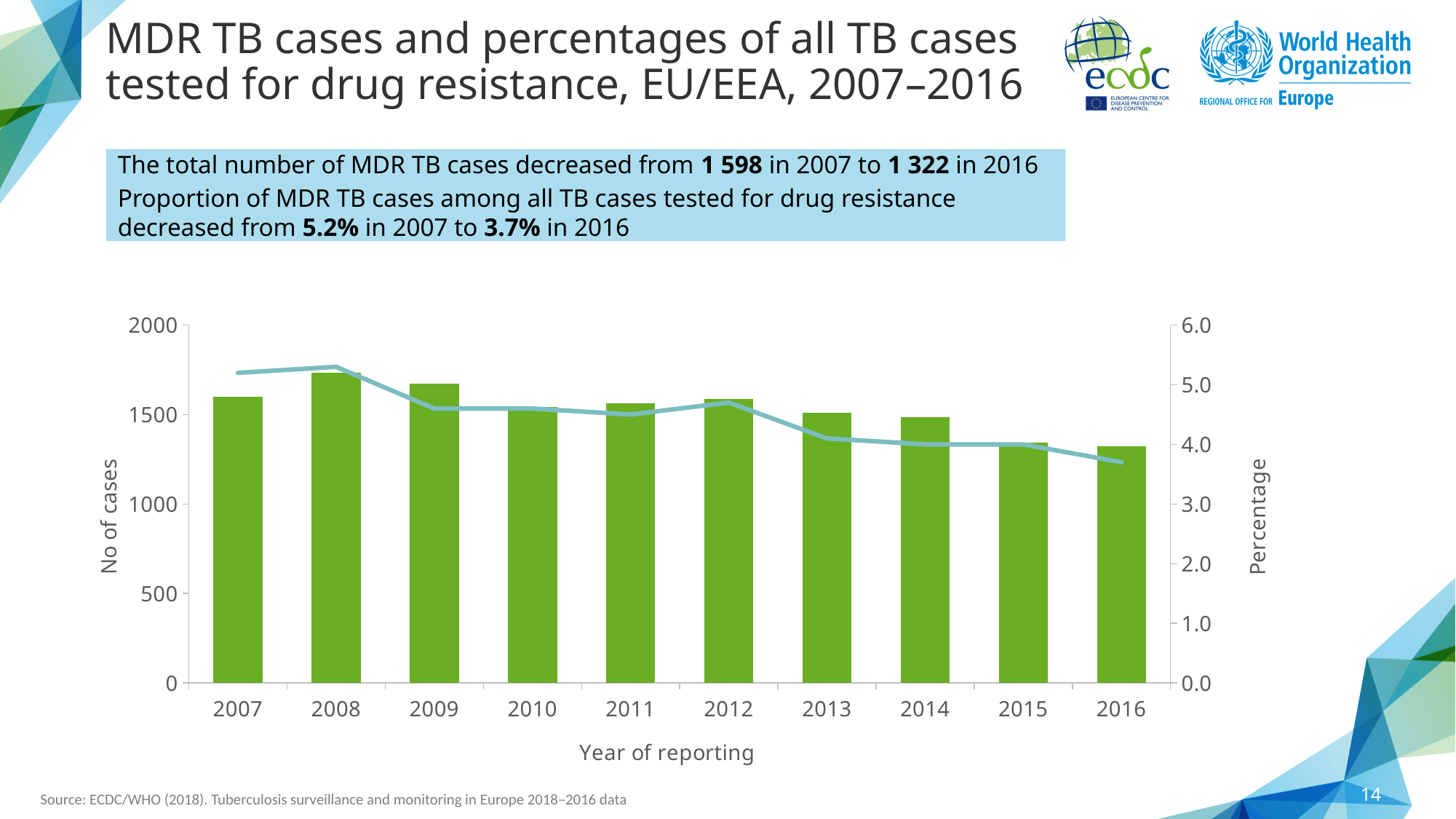
What is the label of the right-hand vertical axis? Percentage Which year has the highest bar for number of MDR TB cases? 2008 What was the total number of MDR TB cases in 2007? 1 598 Is the percentage value for 2013 greater or less than 5.0? less Which year has a higher bar for number of MDR TB cases, 2009 or 2013? 2009 What kind of chart is shown on the slide? bar chart with a line What was the total number of MDR TB cases in 2016? 1 322 What was the proportion of MDR TB cases among all TB cases tested for drug resistance in 2016? 3.7% Is the number of MDR TB cases in 2015 greater or less than 1500? less How many years of reporting are shown on the x axis of the chart? 10 Which year has the lowest point on the percentage line? 2016 By how much did the number of MDR TB cases decrease from 2007 to 2016? 276